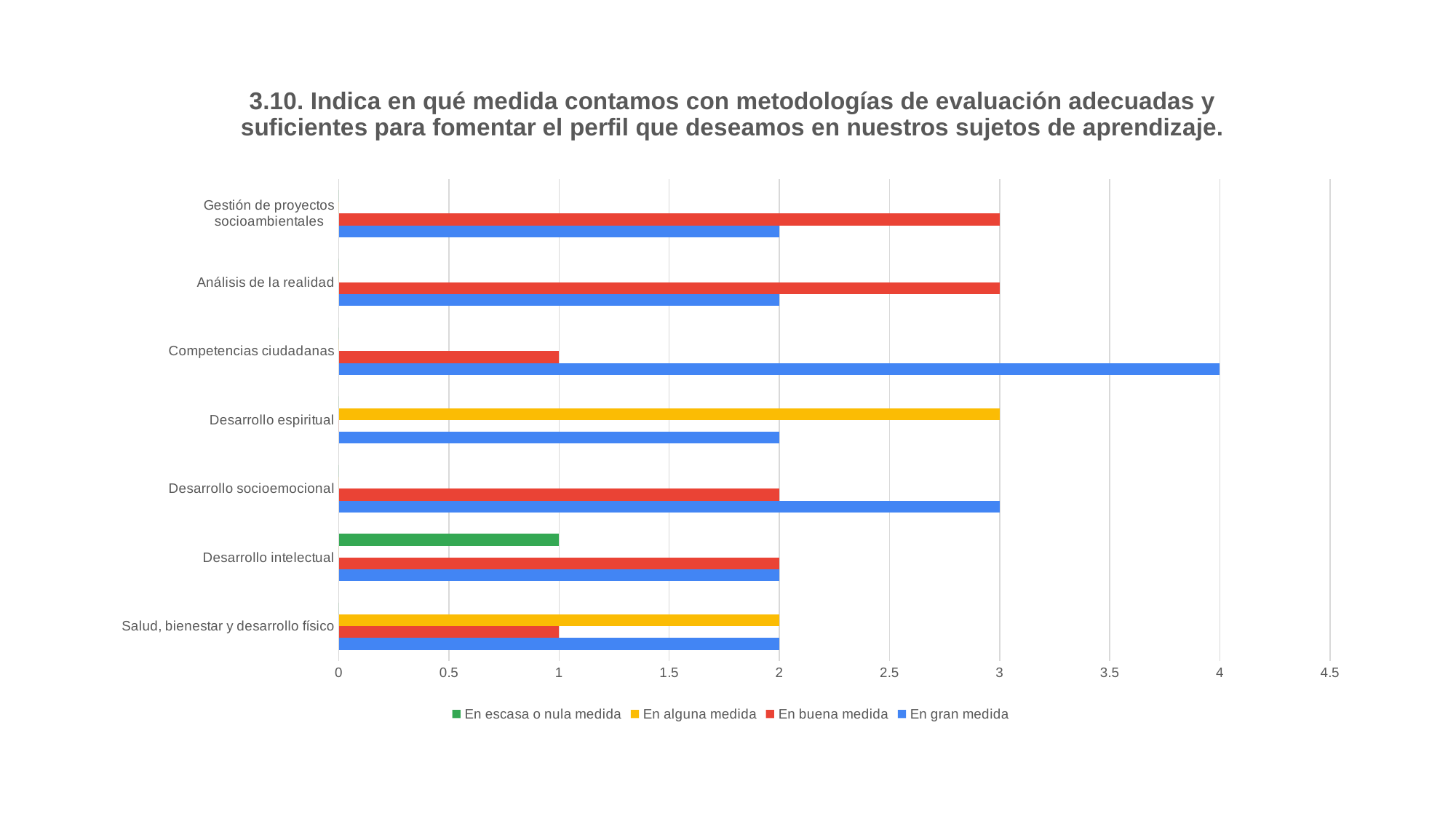
How many categories are listed on the vertical axis of the chart? 7 How many series does the legend list? 4 What is the value of 'En alguna medida' for Desarrollo espiritual? 3 For Desarrollo socioemocional, which is larger: 'En buena medida' or 'En gran medida'? En gran medida What colour represents 'En gran medida' in the legend? blue What kind of chart is shown on the slide? bar chart What is the value of 'En gran medida' for Competencias ciudadanas? 4 Which category has the highest value for 'En gran medida'? Competencias ciudadanas What is the value of 'En buena medida' for Análisis de la realidad? 3 What is the value of 'En escasa o nula medida' for Desarrollo intelectual? 1 Which category is the only one with a bar for 'En escasa o nula medida'? Desarrollo intelectual What is the difference between 'En gran medida' and 'En buena medida' for Competencias ciudadanas? 3